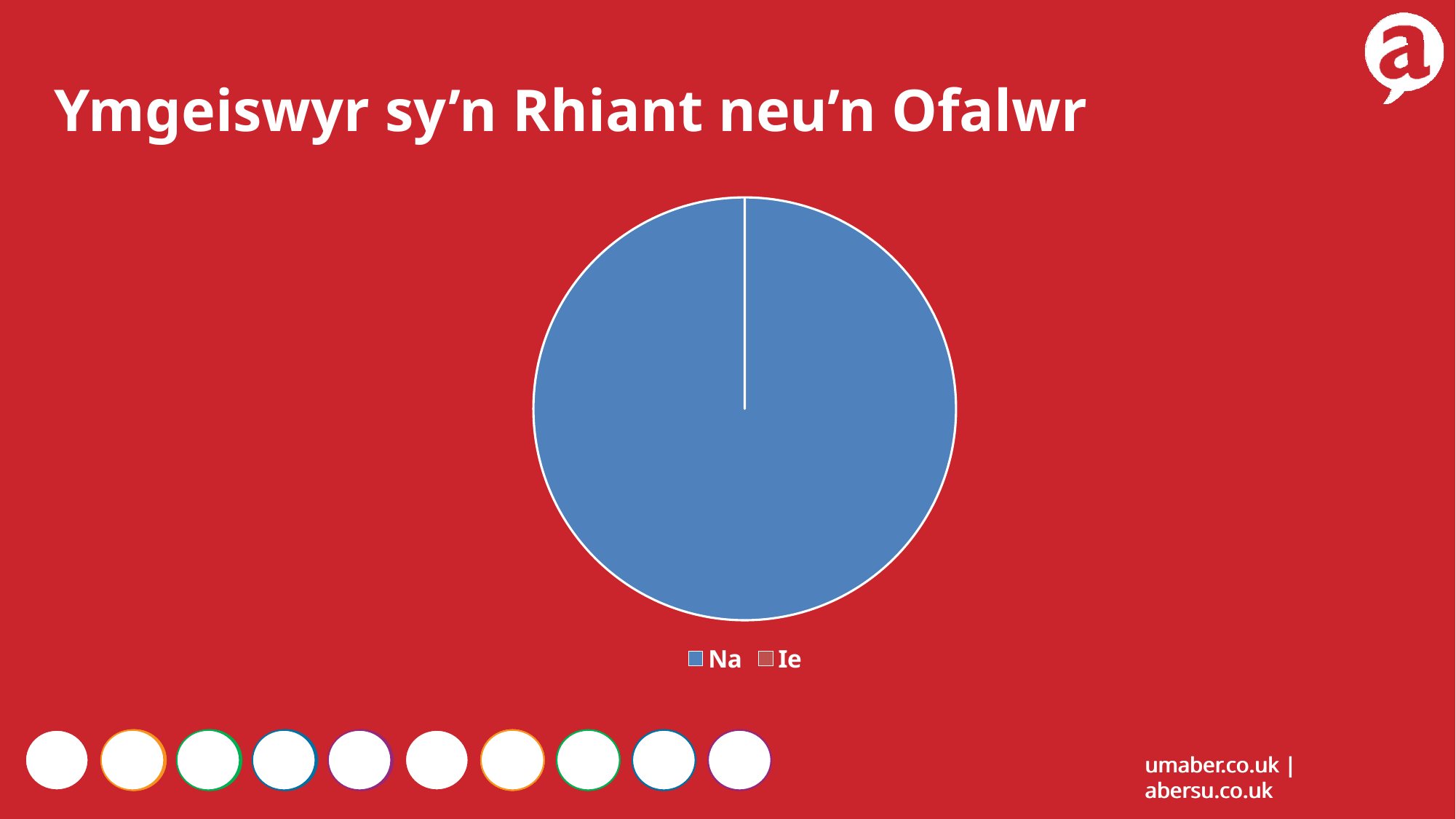
How many categories does the legend of the pie chart list? 2 Which category takes up the smallest share of the pie chart? Ie What colour is the Na slice of the pie chart? blue Which category takes up the largest share of the pie chart? Na What are the two legend entries of the pie chart? Na and Ie What kind of chart is shown on the slide? pie chart What is the title of the chart on the slide? Ymgeiswyr sy’n Rhiant neu’n Ofalwr Which category has the larger share of the pie, Na or Ie? Na